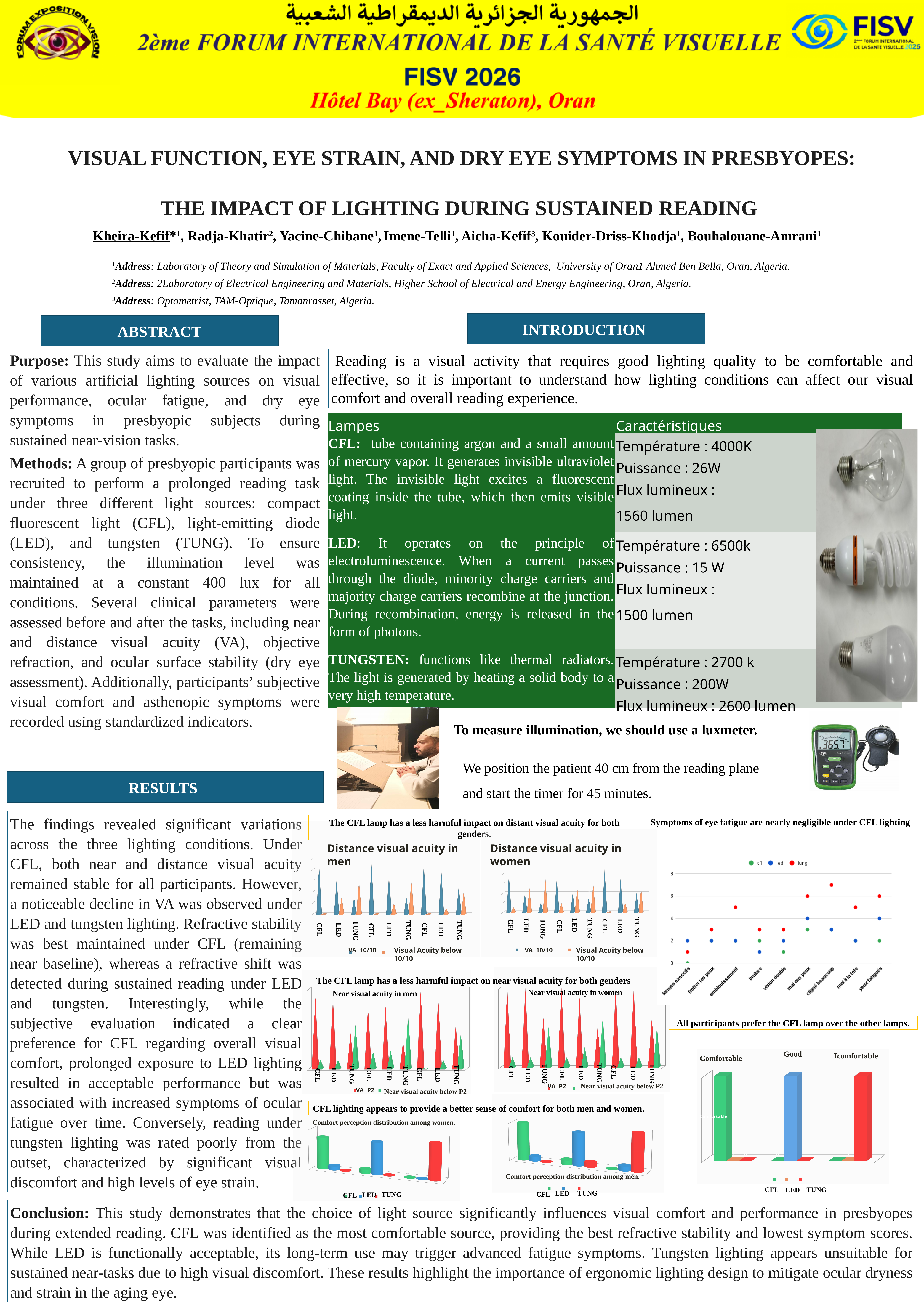
In the chart under the heading "All participants prefer the CFL lamp over the other lamps", how many categories are shown? 3 In the chart titled "Distance visual acuity in men", how many series does the legend list? 2 In the chart titled "Symptoms of eye fatigue are nearly negligible under CFL lighting", what kind of chart is it? scatter chart In the chart titled "Symptoms of eye fatigue are nearly negligible under CFL lighting", which symptom has the highest tung value? cligne beaucoup In the chart titled "Symptoms of eye fatigue are nearly negligible under CFL lighting", is the tung value for "cligne beaucoup" greater or less than 6? greater In the chart under the heading "All participants prefer the CFL lamp over the other lamps", what kind of chart is it? bar chart In the chart titled "Symptoms of eye fatigue are nearly negligible under CFL lighting", is the cfl value for "larmes excessifs" greater or less than 2? less In the chart titled "Symptoms of eye fatigue are nearly negligible under CFL lighting", how many symptom categories are shown on the x axis? 9 In the chart titled "Symptoms of eye fatigue are nearly negligible under CFL lighting", how many series does the legend list? 3 In the chart titled "Distance visual acuity in men", how many category labels are shown along the x axis? 9 In the chart titled "Near visual acuity in women", what are the two legend entries? VA P2; Near visual acuity below P2 In the chart titled "Comfort perception distribution among men", which lamps are listed in the legend? CFL, LED, TUNG